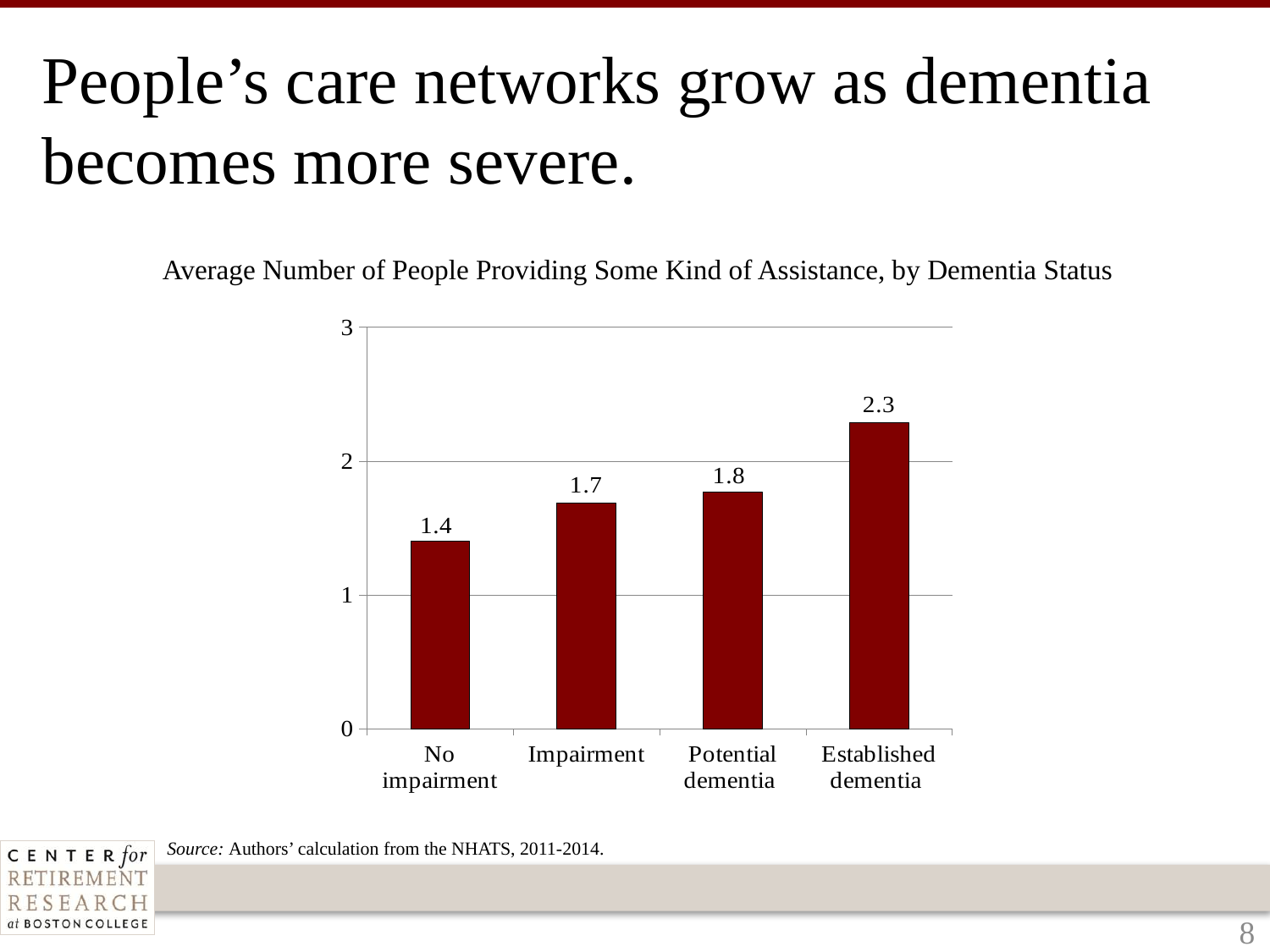
Which dementia status category has the highest average number of people providing assistance? Established dementia How many dementia status categories are shown in the chart? 4 What is the value shown for Established dementia? 2.3 Is the value for Established dementia greater or less than 2? greater What is the difference between the values for Established dementia and No impairment? 0.9 Which is larger, the value for Impairment or the value for Established dementia? Established dementia What is the average number of people providing assistance for the No impairment category? 1.4 What is the value shown for Potential dementia? 1.8 Which category has the lowest value in the chart? No impairment What kind of chart is shown on the slide? Bar chart What is the difference between the values for Potential dementia and Impairment? 0.1 Do the values rise or fall moving from No impairment to Established dementia? Rise